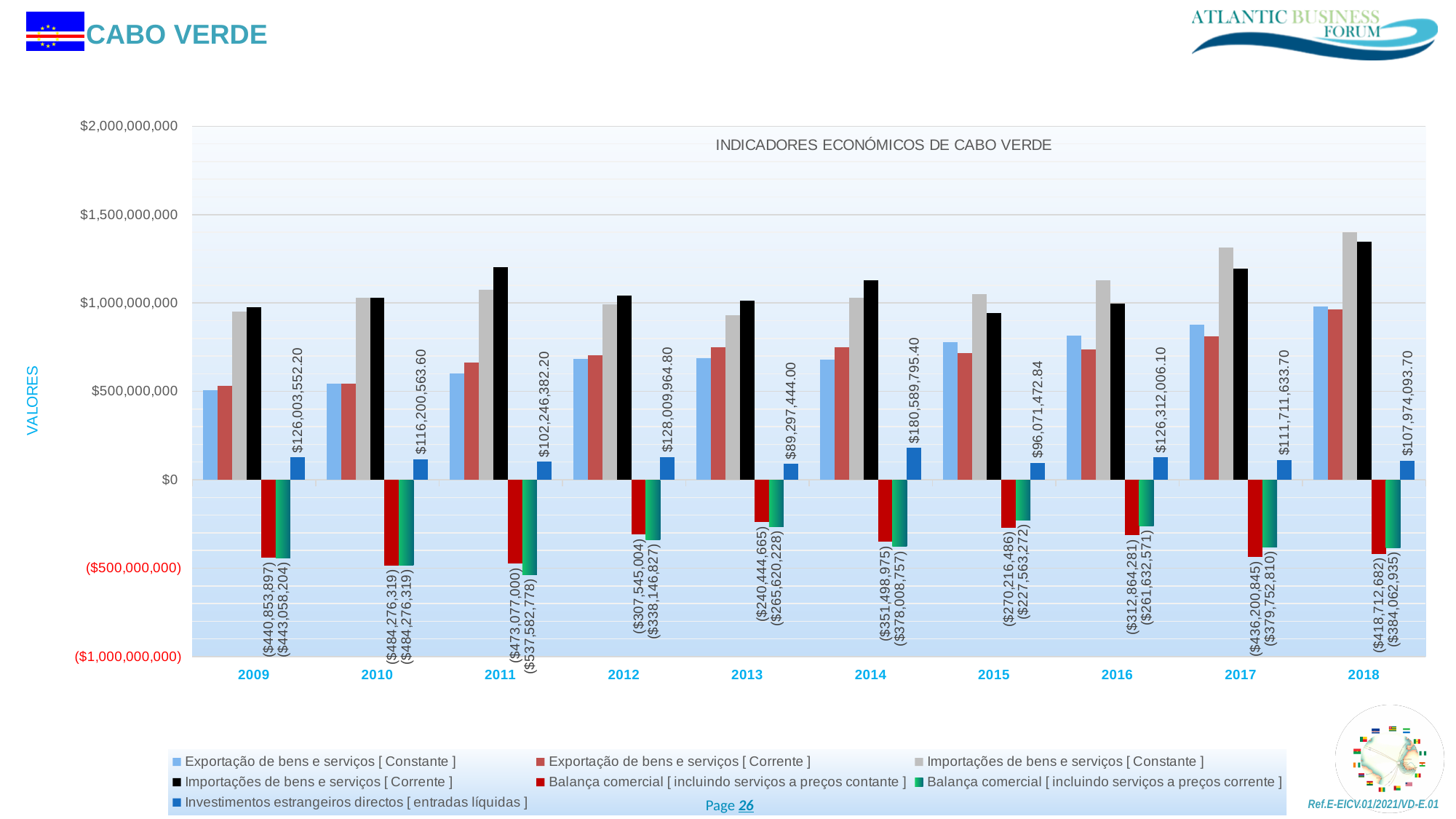
What is the difference between Investimentos estrangeiros directos [ entradas líquidas ] in 2014 and in 2013? $91,292,351.40 Which year has the larger value of Investimentos estrangeiros directos [ entradas líquidas ], 2009 or 2010? 2009 Is the value of Exportação de bens e serviços [ Corrente ] for 2011 greater or less than $500,000,000? greater Is the value of Importações de bens e serviços [ Corrente ] for 2018 greater or less than $1,000,000,000? greater What is the value of Balança comercial [ incluindo serviços a preços corrente ] for 2018? ($384,062,935) How many years are shown on the x axis of the chart? 10 What is the value of Balança comercial [ incluindo serviços a preços contante ] for 2011? ($473,077,000) What is the value of Investimentos estrangeiros directos [ entradas líquidas ] for 2014? $180,589,795.40 How many series does the chart legend list? 7 In which year is Investimentos estrangeiros directos [ entradas líquidas ] lowest? 2013 In which year is Investimentos estrangeiros directos [ entradas líquidas ] highest? 2014 What type of chart is shown on the slide? Bar chart